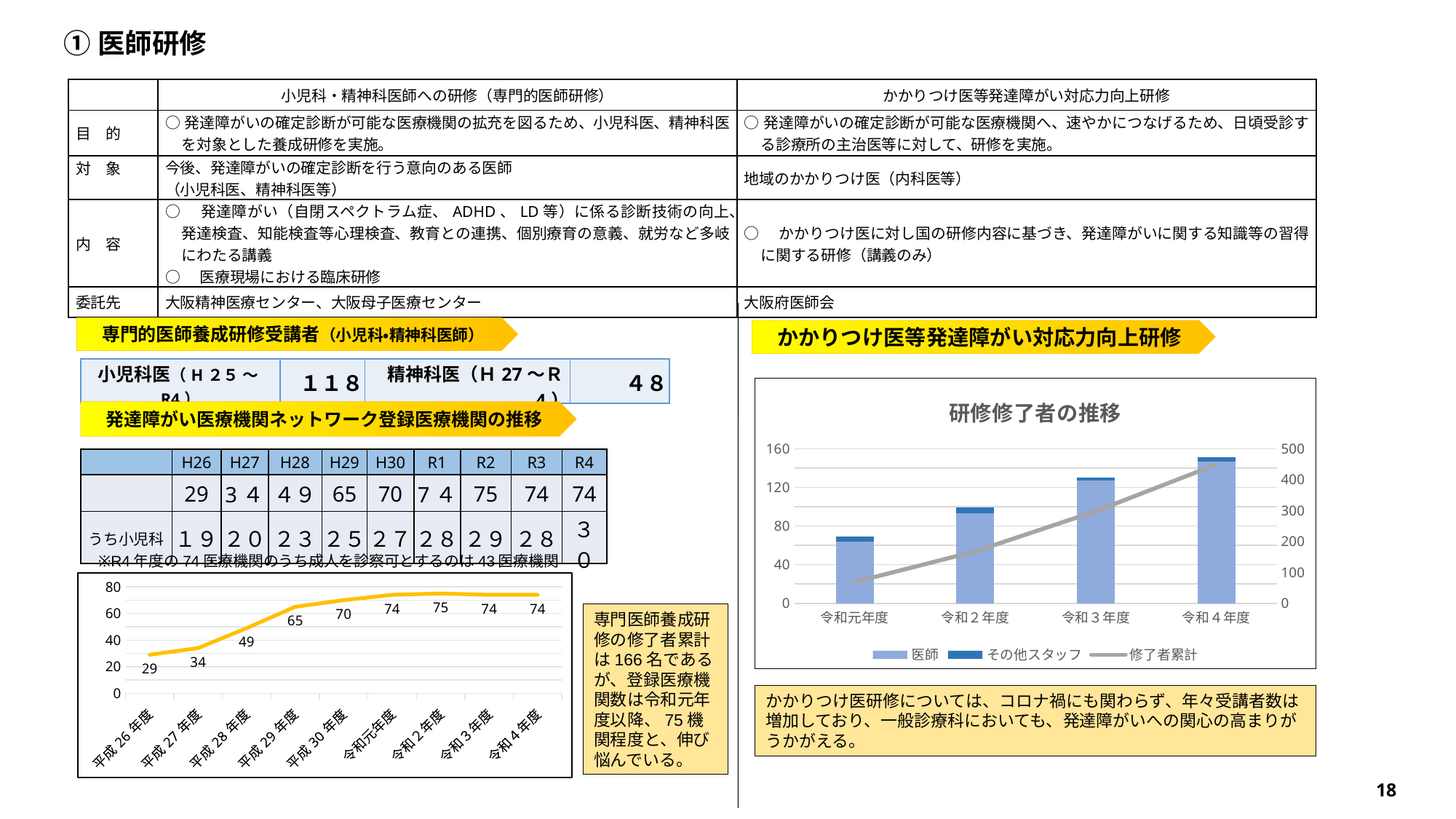
In the chart titled 研修修了者の推移, which year has the tallest bar? 令和4年度 In the line chart at the bottom left of the slide, which year has the highest value? 令和2年度 In the chart titled 研修修了者の推移, how many series does the legend list? 3 In the line chart at the bottom left of the slide, what is the value for 平成28年度? 49 In the line chart at the bottom left of the slide, how many years are plotted? 9 In the line chart at the bottom left of the slide, what is the value for 令和2年度? 75 In the line chart at the bottom left of the slide, what is the difference between the values for 令和2年度 and 平成26年度? 46 In the chart titled 研修修了者の推移, which series is shown as a grey line? 修了者累計 What kind of chart is the chart at the bottom left of the slide? Line chart In the chart titled 研修修了者の推移, is the total bar height for 令和元年度 greater or less than 80? less In the chart titled 研修修了者の推移, does the 修了者累計 line rise or fall from 令和元年度 to 令和4年度? Rises In the line chart at the bottom left of the slide, which year has the lowest value? 平成26年度